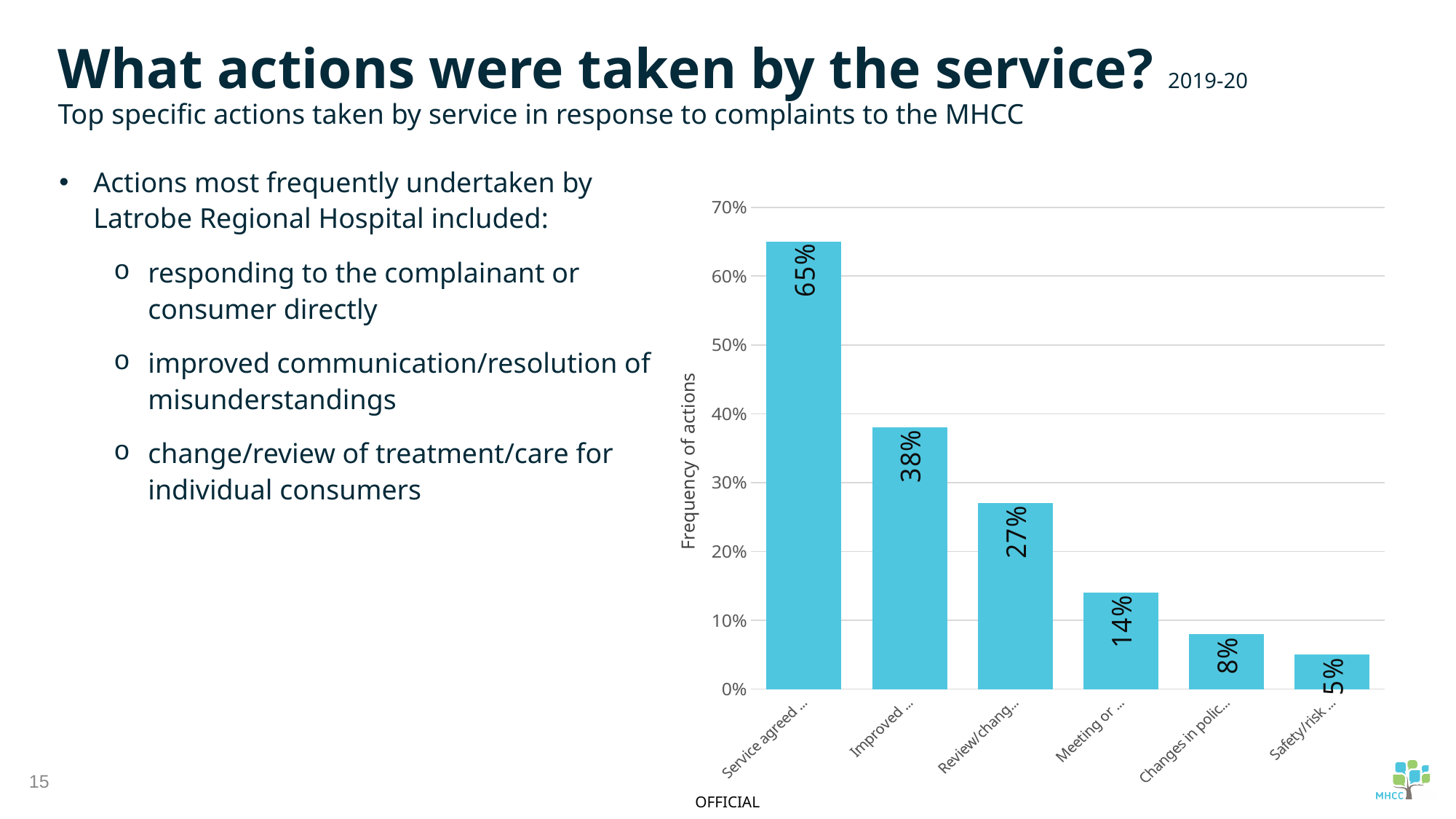
What is the value of the bar labelled 'Meeting or ...'? 14% What is the value of the first bar, labelled 'Service agreed ...'? 65% Which is larger: the value for 'Changes in polic...' or the value for 'Meeting or ...'? Meeting or ... What is the value of the last bar, labelled 'Safety/risk ...'? 5% Do the bar values rise or fall from left to right along the x axis? fall How many bars (categories) are plotted in the chart? 6 What is the value of the bar labelled 'Review/chang...'? 27% What type of chart is shown on the slide? bar chart Which category has the lowest value in the chart? Safety/risk ... What is the value of the bar labelled 'Improved ...'? 38% What is the label of the vertical (y) axis of the chart? Frequency of actions What is the difference between the values of the 'Service agreed ...' bar and the 'Improved ...' bar? 27%